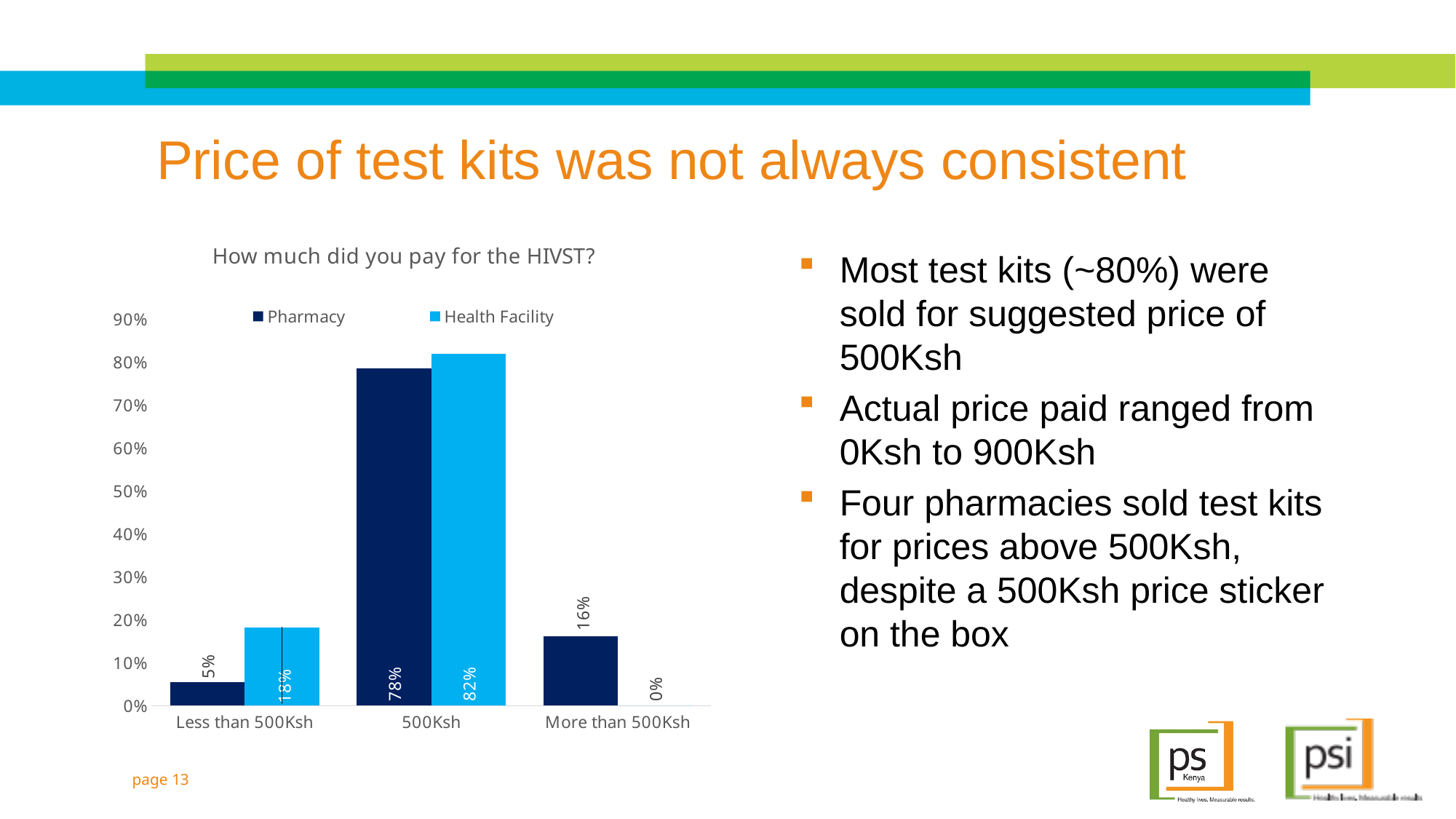
Which price category has the highest Pharmacy value? 500Ksh What is the Pharmacy value for 'More than 500Ksh'? 16% Which price category has the lowest Health Facility value? More than 500Ksh How many series does the chart legend list? 2 How many price categories are shown on the x axis of the chart? 3 What percentage of Pharmacy respondents paid 500Ksh for the HIVST? 78% What kind of chart is shown on the slide? bar chart What is the Health Facility value for 'Less than 500Ksh'? 18% What is the difference between the Health Facility and Pharmacy values for 'Less than 500Ksh'? 13% What percentage of Health Facility respondents paid 500Ksh for the HIVST? 82% For 'More than 500Ksh', which series has the larger value, Pharmacy or Health Facility? Pharmacy What is the title of the chart? How much did you pay for the HIVST?